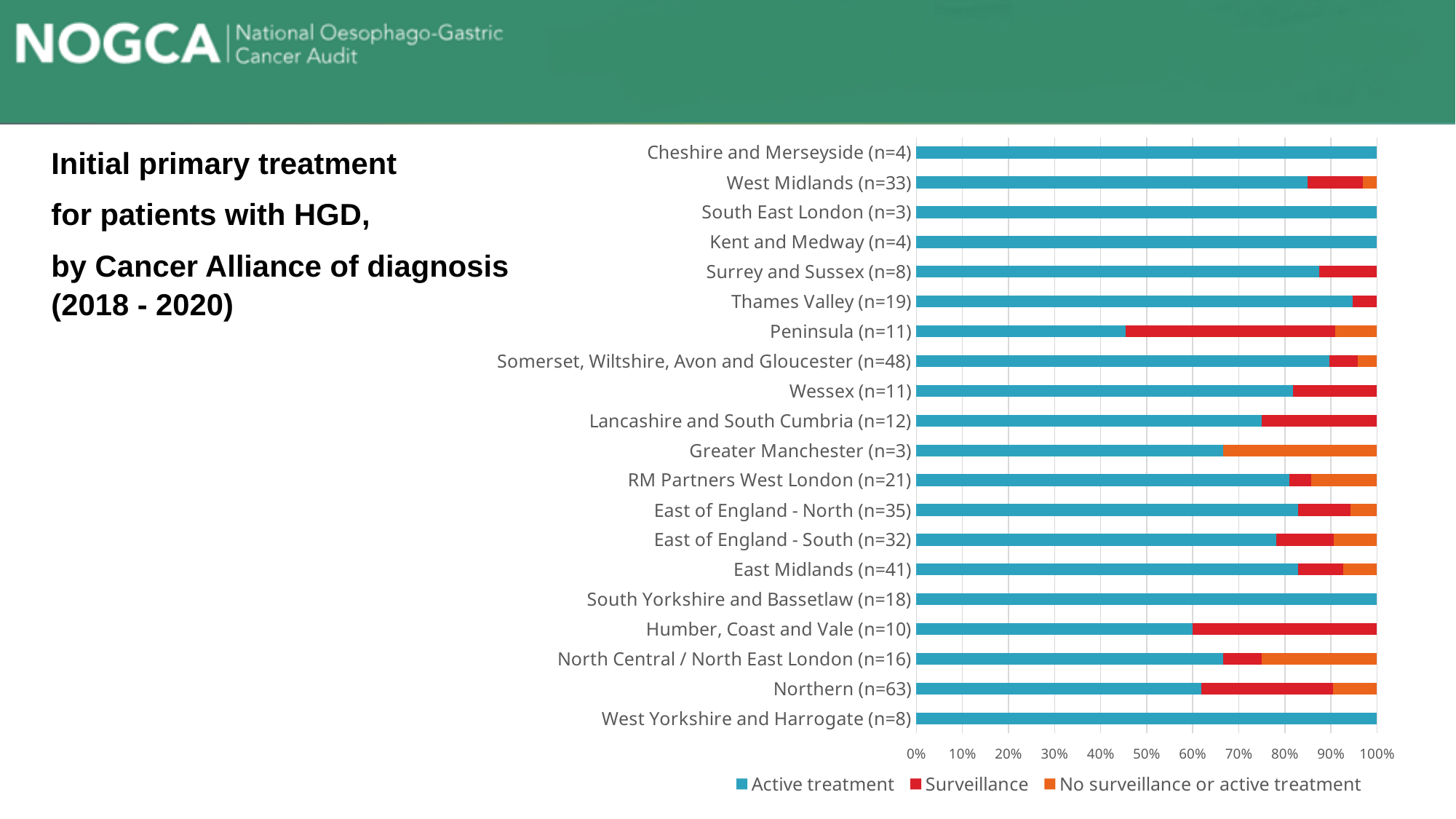
How many Cancer Alliances are listed on the chart? 20 How many series does the legend list? 3 Which Cancer Alliance has the lowest Active treatment share? Peninsula (n=11) Is the Active treatment share for Greater Manchester (n=3) greater or less than 60%? greater Which Cancer Alliance has the largest share of No surveillance or active treatment? Greater Manchester (n=3) What kind of chart is shown on the slide? Stacked bar chart How many Cancer Alliances show 100% Active treatment? 5 Is the Active treatment share for Lancashire and South Cumbria (n=12) greater or less than 70%? greater What colour represents Surveillance in the legend? Red Which has the larger Active treatment share, Peninsula (n=11) or Thames Valley (n=19)? Thames Valley (n=19) Is the Active treatment share for Peninsula (n=11) greater or less than 50%? less